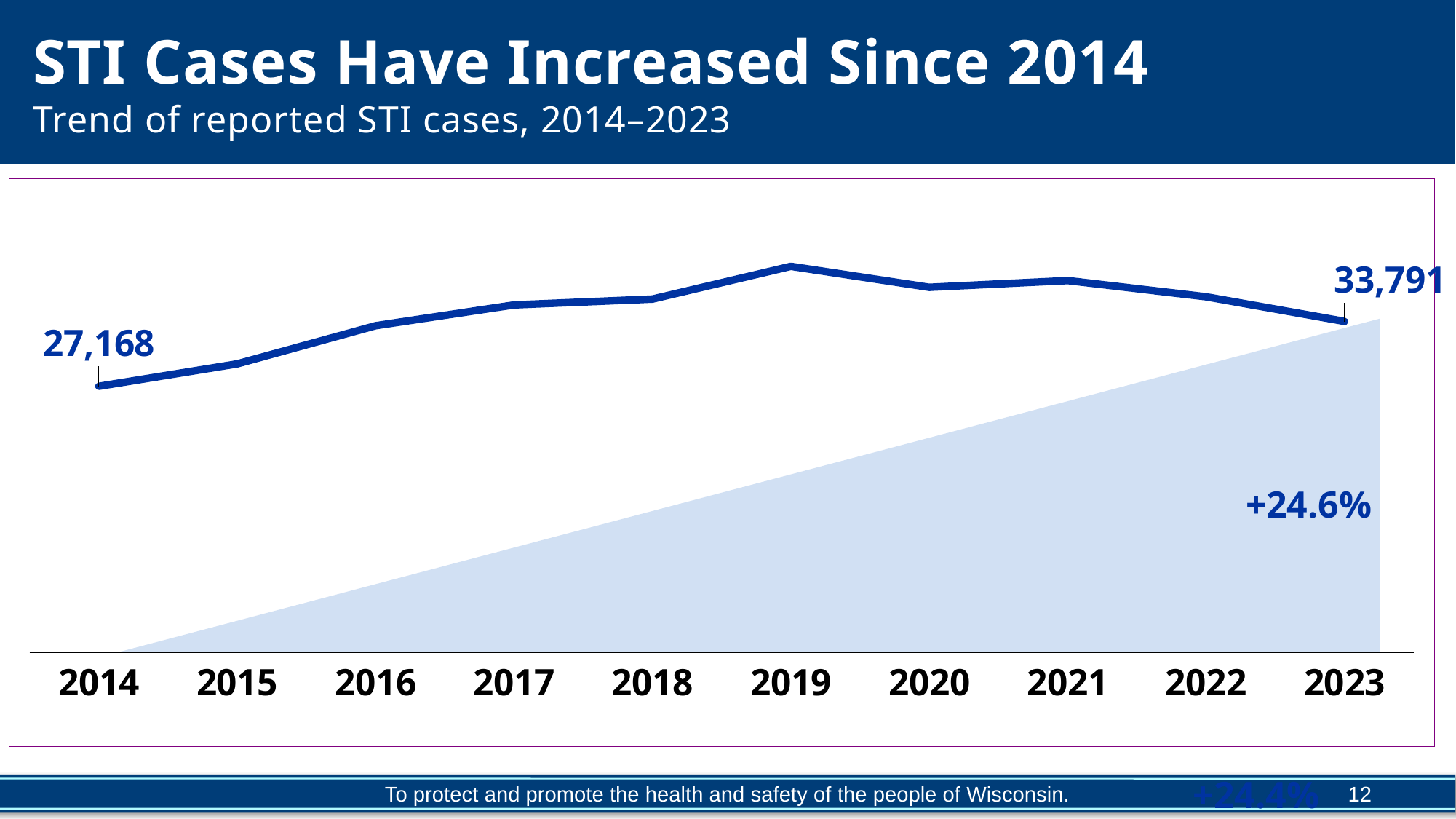
Which year has the highest number of reported STI cases? 2019 Do reported STI cases rise or fall overall from 2014 to 2023? Rise What is the subtitle of the chart on the slide? Trend of reported STI cases, 2014–2023 Which year has more reported STI cases, 2019 or 2020? 2019 What percentage change is annotated on the chart? +24.6% Which year has the lowest number of reported STI cases? 2014 What kind of chart is used to show the trend of reported STI cases? Line chart How many years are shown on the x axis of the chart? 10 Which year has more reported STI cases, 2014 or 2023? 2023 What is the difference between the reported STI cases in 2023 and in 2014? 6,623 What is the number of reported STI cases in 2014? 27,168 What is the number of reported STI cases in 2023? 33,791